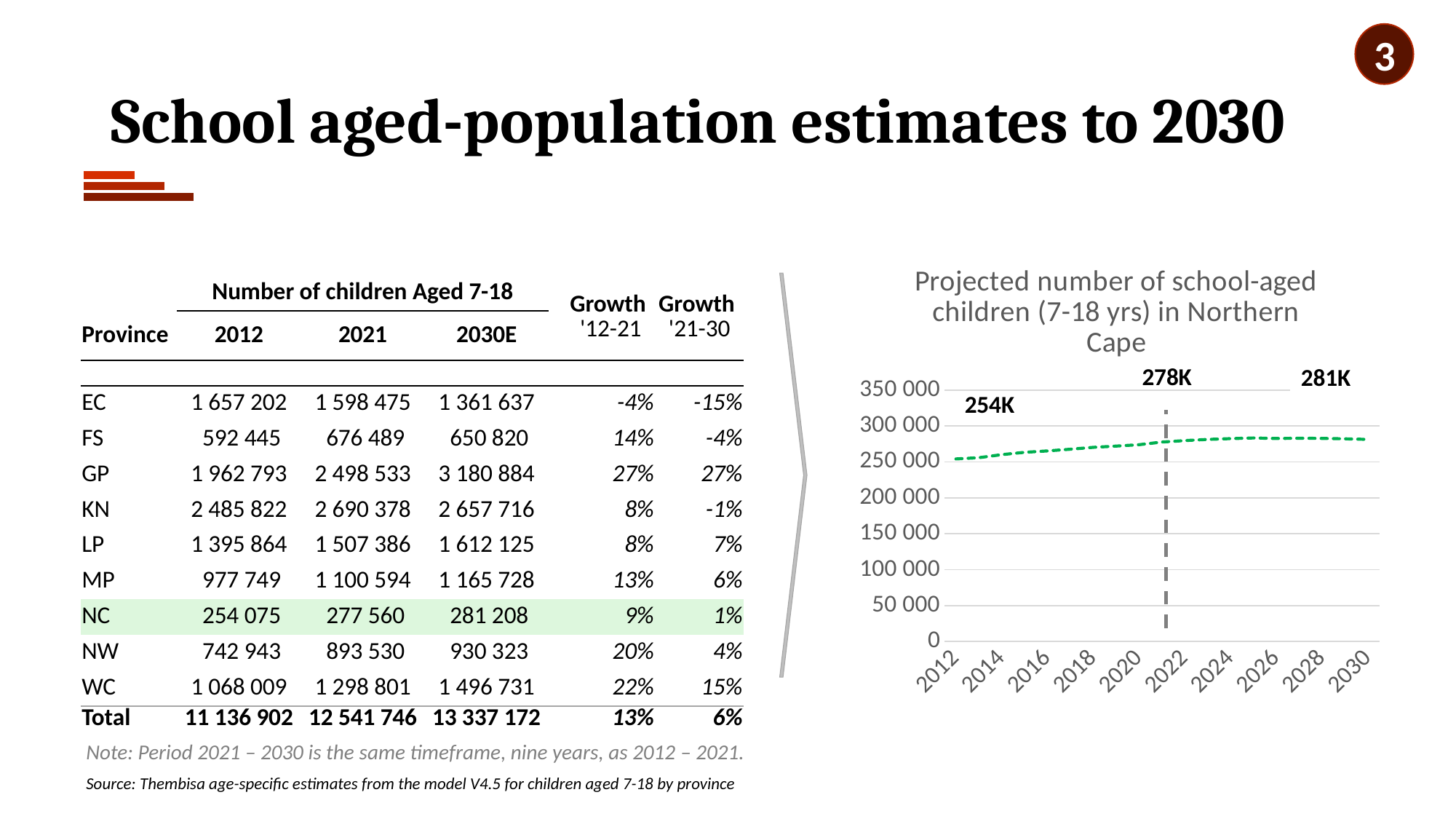
In the chart on the right, which labelled point is the highest: 2012, 2021 or 2030? 2030 In the chart on the right, what value is labelled at the start of the line in 2012? 254K In the chart on the right, which labelled point is the lowest: 2012, 2021 or 2030? 2012 In the chart on the right, what is the difference between the labelled values for 2030 and 2012? 27K What kind of chart is shown on the right of the slide? line chart In the chart on the right, how many year labels are shown on the x axis? 10 In the chart on the right, is the value for 2012 greater or less than 300 000? less What is the title of the chart on the right of the slide? Projected number of school-aged children (7-18 yrs) in Northern Cape In the chart on the right, does the projected number of school-aged children rise or fall from 2012 to 2030? rise In the chart on the right, what value is labelled at the dashed vertical line around 2021? 278K In the chart on the right, what value is labelled at the end of the line in 2030? 281K In the chart on the right, is the value for 2030 greater or less than 250 000? greater